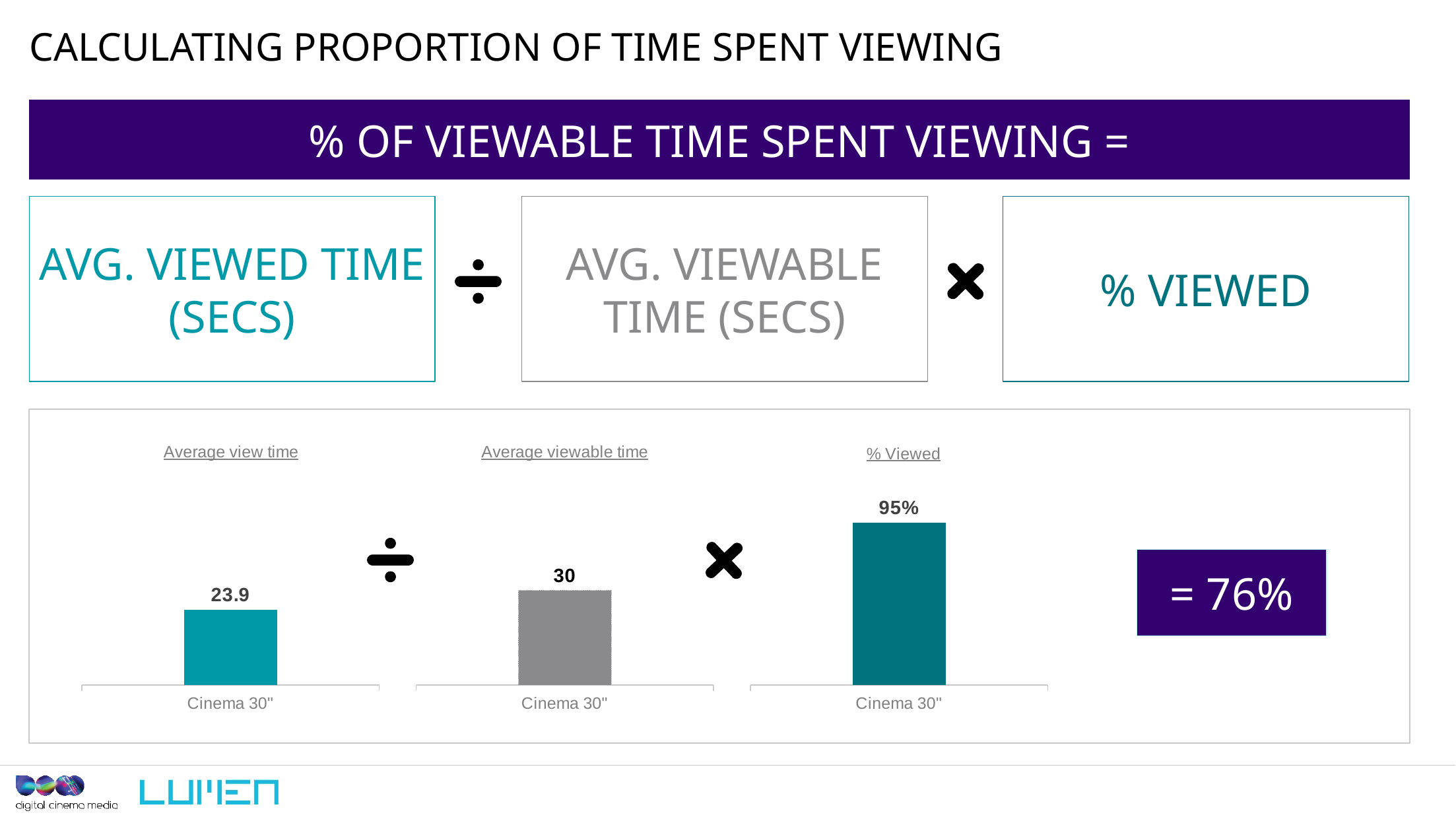
What is the category label on the x axis of the 'Average view time' chart? Cinema 30" What kind of chart is the 'Average view time' chart? bar chart In the '% Viewed' chart, what is the value for Cinema 30"? 95% How many separate bar charts are shown on the slide? 3 Which is larger: the Cinema 30" value in the 'Average view time' chart or the Cinema 30" value in the 'Average viewable time' chart? Average viewable time How many categories does the 'Average viewable time' chart show? 1 What is the title of the leftmost chart on the slide? Average view time What is the difference between the Cinema 30" value in the 'Average viewable time' chart and the Cinema 30" value in the 'Average view time' chart? 6.1 How many bars are plotted in the '% Viewed' chart? 1 In the 'Average viewable time' chart, what is the value for Cinema 30"? 30 In the 'Average view time' chart, what is the value for Cinema 30"? 23.9